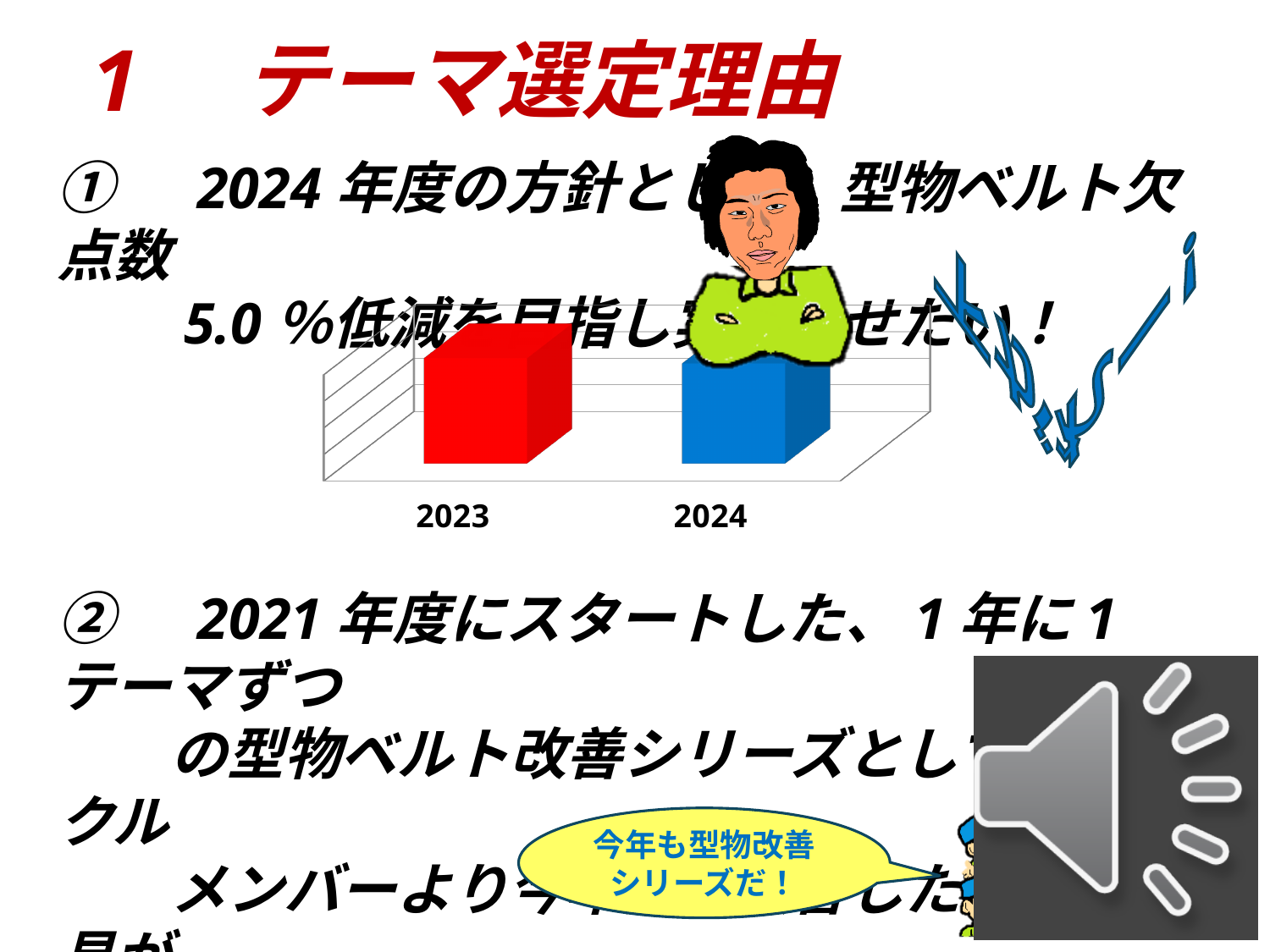
Is the bar for 2023 taller or shorter than the bar for 2024? taller What colour is the bar for 2023? red Which category has the lowest bar in the chart? 2024 Do the bar values rise or fall from 2023 to 2024? fall How many categories are shown on the x axis of the chart? 2 What kind of chart is shown on the slide? bar chart What colour is the bar for 2024? blue Which category has the highest bar in the chart? 2023